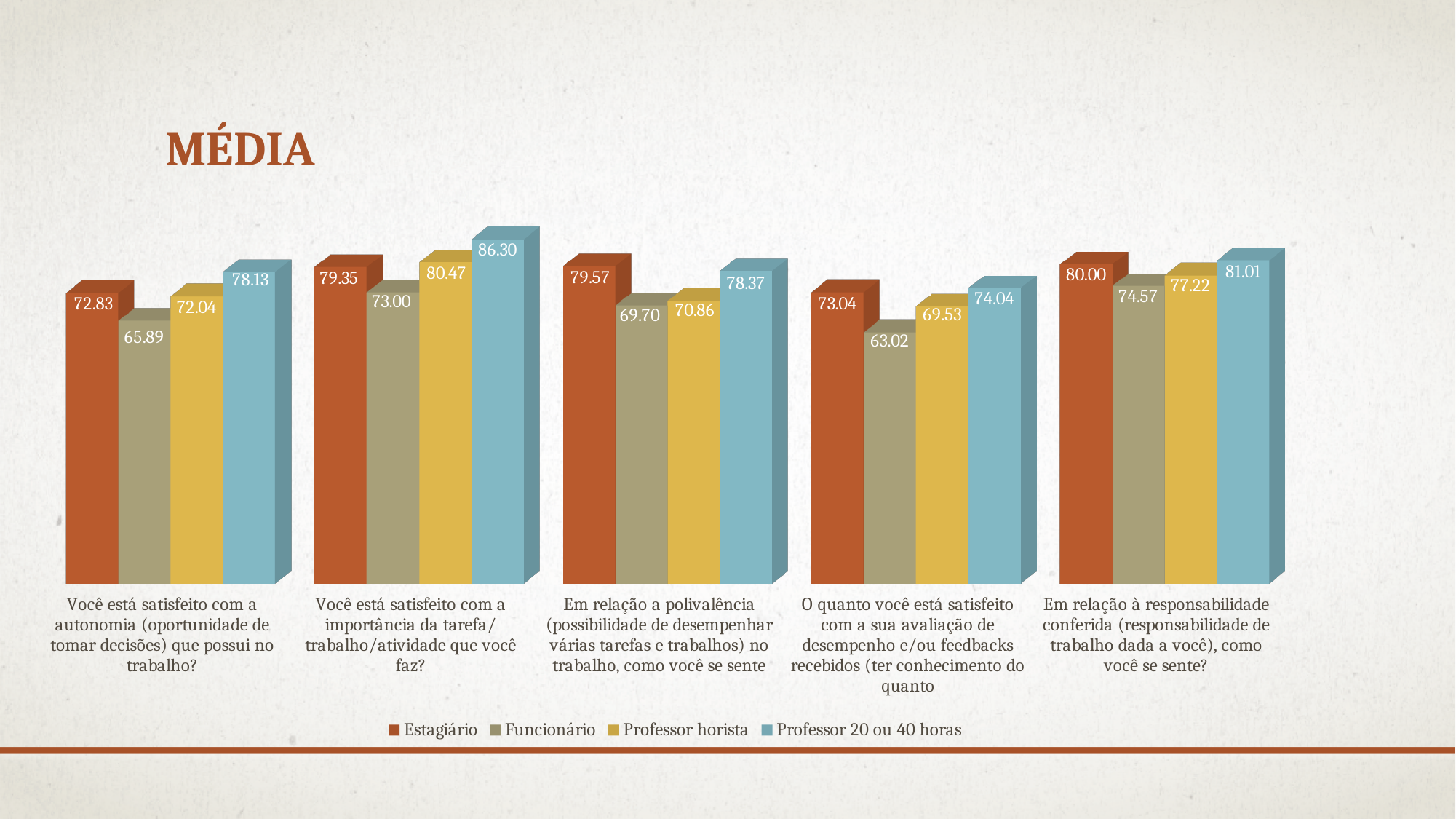
How many series does the legend list? 4 What is the value for Professor 20 ou 40 horas in the category about importância da tarefa/trabalho/atividade? 86.30 How many categories (questions) are shown on the x axis? 5 In the category about polivalência, which is larger: the Estagiário value or the Professor 20 ou 40 horas value? Estagiário What is the value for Estagiário in the category about polivalência? 79.57 Which series has the lowest value in the category about avaliação de desempenho e/ou feedbacks? Funcionário What is the value for Professor horista in the category about avaliação de desempenho e/ou feedbacks? 69.53 What kind of chart is shown on the slide? Bar chart What is the title of the chart? MÉDIA What is the difference between the Professor 20 ou 40 horas value and the Funcionário value in the category about importância da tarefa? 13.30 What is the value for Funcionário in the first category (satisfaction with autonomia)? 65.89 Which series has the highest value in the category about responsabilidade conferida? Professor 20 ou 40 horas